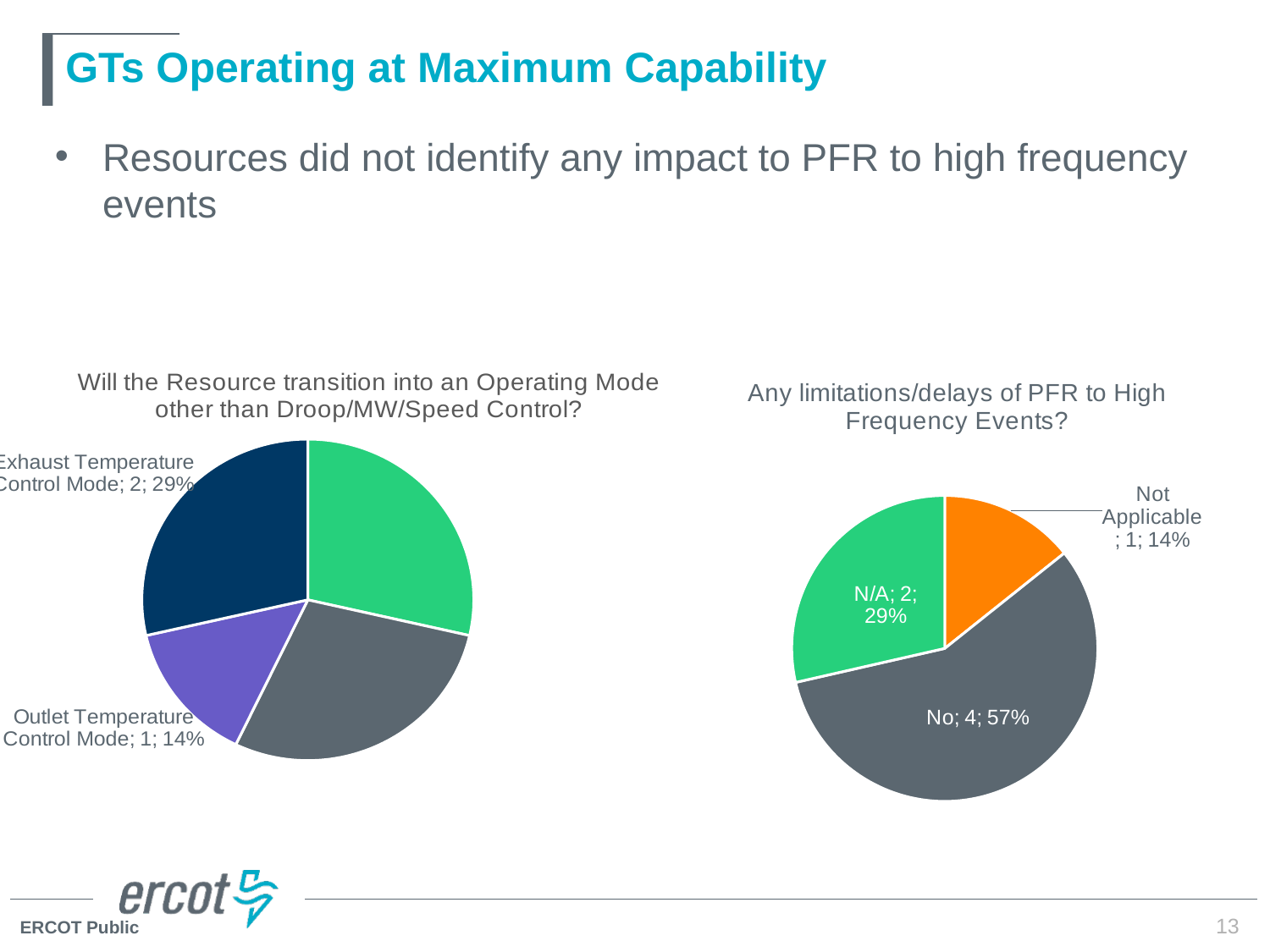
How many slices does the pie chart on the left of the slide have? 4 In the pie chart on the left of the slide, what is the difference between the counts for "Exhaust Temperature Control Mode" and "Outlet Temperature Control Mode"? 1 In the pie chart titled "Any limitations/delays of PFR to High Frequency Events?", what percentage share does the "No" slice have? 57% In the pie chart on the left titled "Will the Resource transition into an Operating Mode other than Droop/MW/Speed Control?", what percentage share does "Exhaust Temperature Control Mode" have? 29% In the pie chart titled "Any limitations/delays of PFR to High Frequency Events?", what is the count shown for "No"? 4 In the pie chart titled "Any limitations/delays of PFR to High Frequency Events?", which category has the largest slice? No What type of chart is the chart on the right of the slide? Pie chart In the pie chart titled "Any limitations/delays of PFR to High Frequency Events?", what is the difference between the counts for "No" and "N/A"? 2 In the pie chart on the left of the slide, which is larger: the slice for "Exhaust Temperature Control Mode" or the slice for "Outlet Temperature Control Mode"? Exhaust Temperature Control Mode In the pie chart on the left of the slide, what is the count shown for "Outlet Temperature Control Mode"? 1 In the pie chart titled "Any limitations/delays of PFR to High Frequency Events?", which category has the smallest slice? Not Applicable How many slices does the pie chart titled "Any limitations/delays of PFR to High Frequency Events?" have? 3